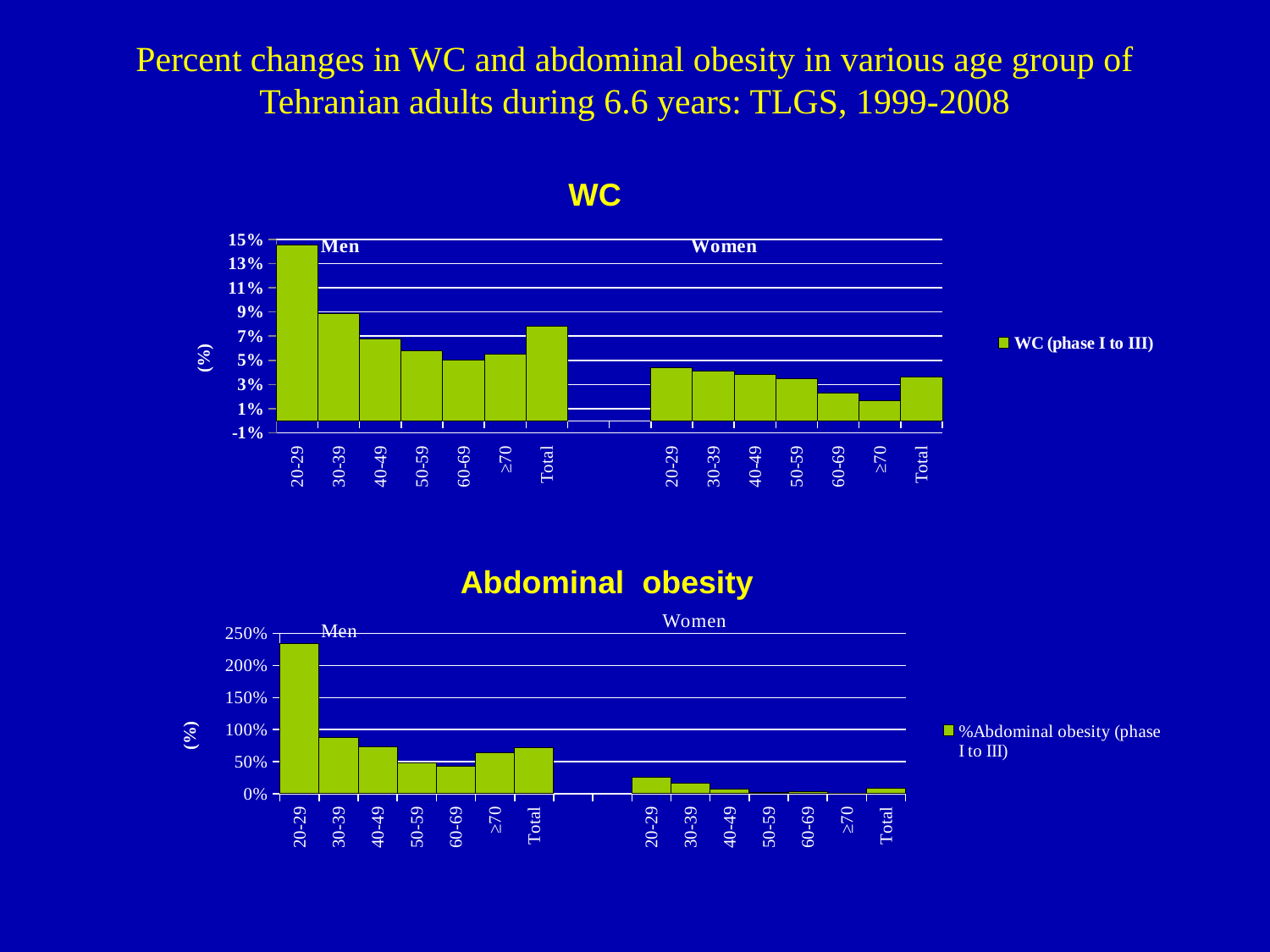
In the WC chart, is the value for the men's Total bar greater or less than 7%? greater In the WC chart, which group has the highest bar? Men 20-29 In the WC chart, which is larger: the value for men aged 30-39 or men aged 40-49? Men 30-39 What kind of chart is the Abdominal obesity chart? bar chart In the WC chart, is the value for women aged 60-69 greater or less than 3%? less In the Abdominal obesity chart, is the value for men aged 20-29 greater or less than 200%? greater In the WC chart, do the women's values rise or fall from the 20-29 group to the ≥70 group? fall In the WC chart, how many series does the legend list? 1 In the WC chart, which group has the lowest bar? Women ≥70 In the Abdominal obesity chart, which group has the highest bar? Men 20-29